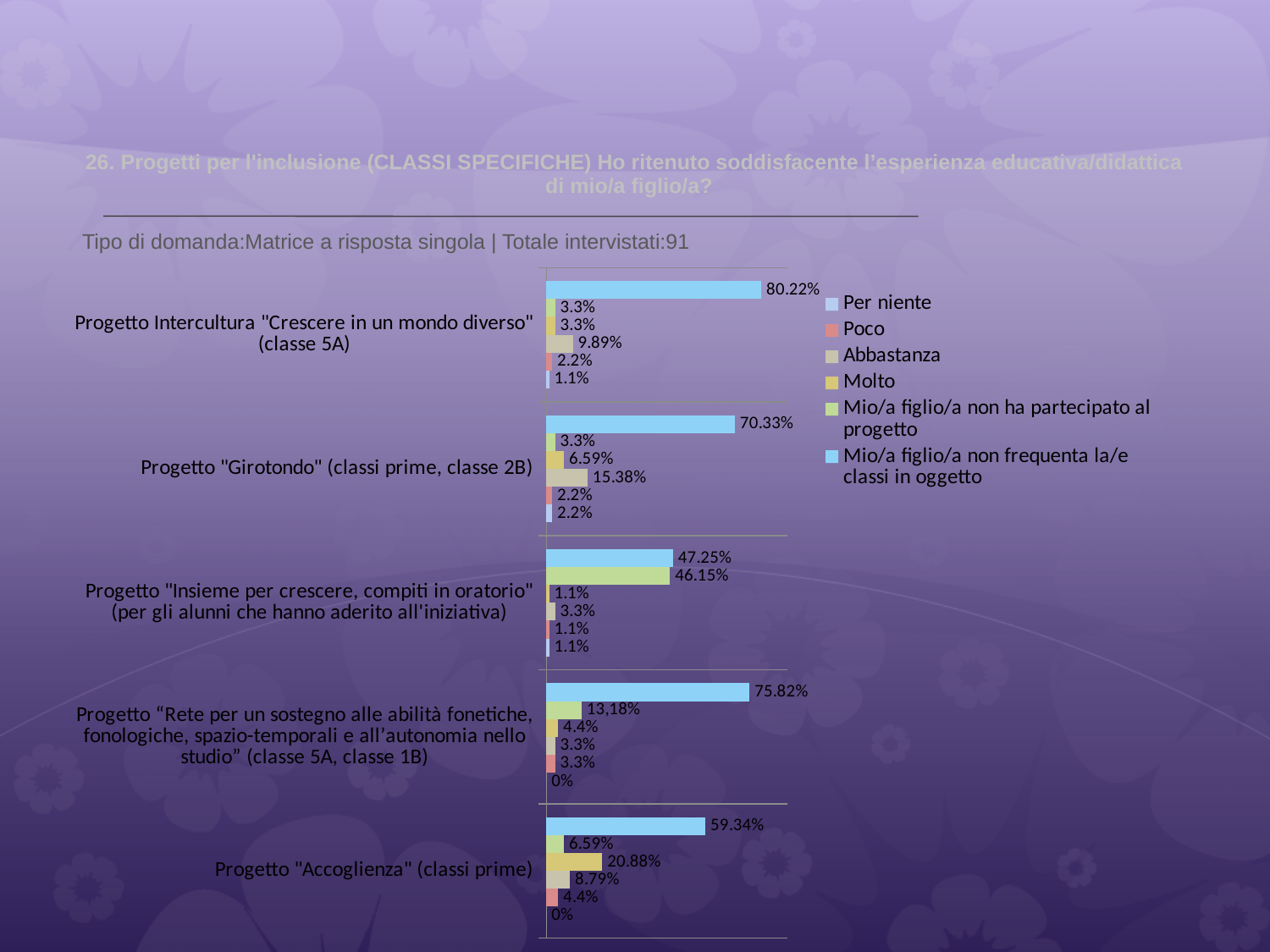
What is the 'Molto' value for Progetto "Accoglienza" (classi prime)? 20.88% What is the difference between the largest value for Progetto Intercultura (80.22%) and the largest value for Progetto "Girotondo" (70.33%)? 9.89% Which project has the highest value for 'Mio/a figlio/a non frequenta la/e classi in oggetto'? Progetto Intercultura "Crescere in un mondo diverso" (classe 5A) How many projects (categories) are shown in the chart? 5 What is the largest value shown for Progetto "Girotondo" (classi prime, classe 2B)? 70.33% What kind of chart is shown on the slide? bar chart How many series does the chart legend list? 6 Which is larger: the 'Abbastanza' value for Progetto "Girotondo" or the 'Abbastanza' value for Progetto Intercultura? Progetto "Girotondo" What is the value of the 'Mio/a figlio/a non ha partecipato al progetto' bar for Progetto "Insieme per crescere, compiti in oratorio"? 46.15% What is the largest value shown for Progetto "Accoglienza" (classi prime)? 59.34% What is the largest value shown for Progetto Intercultura "Crescere in un mondo diverso" (classe 5A)? 80.22% Which project has the lowest value for 'Mio/a figlio/a non frequenta la/e classi in oggetto'? Progetto "Insieme per crescere, compiti in oratorio"